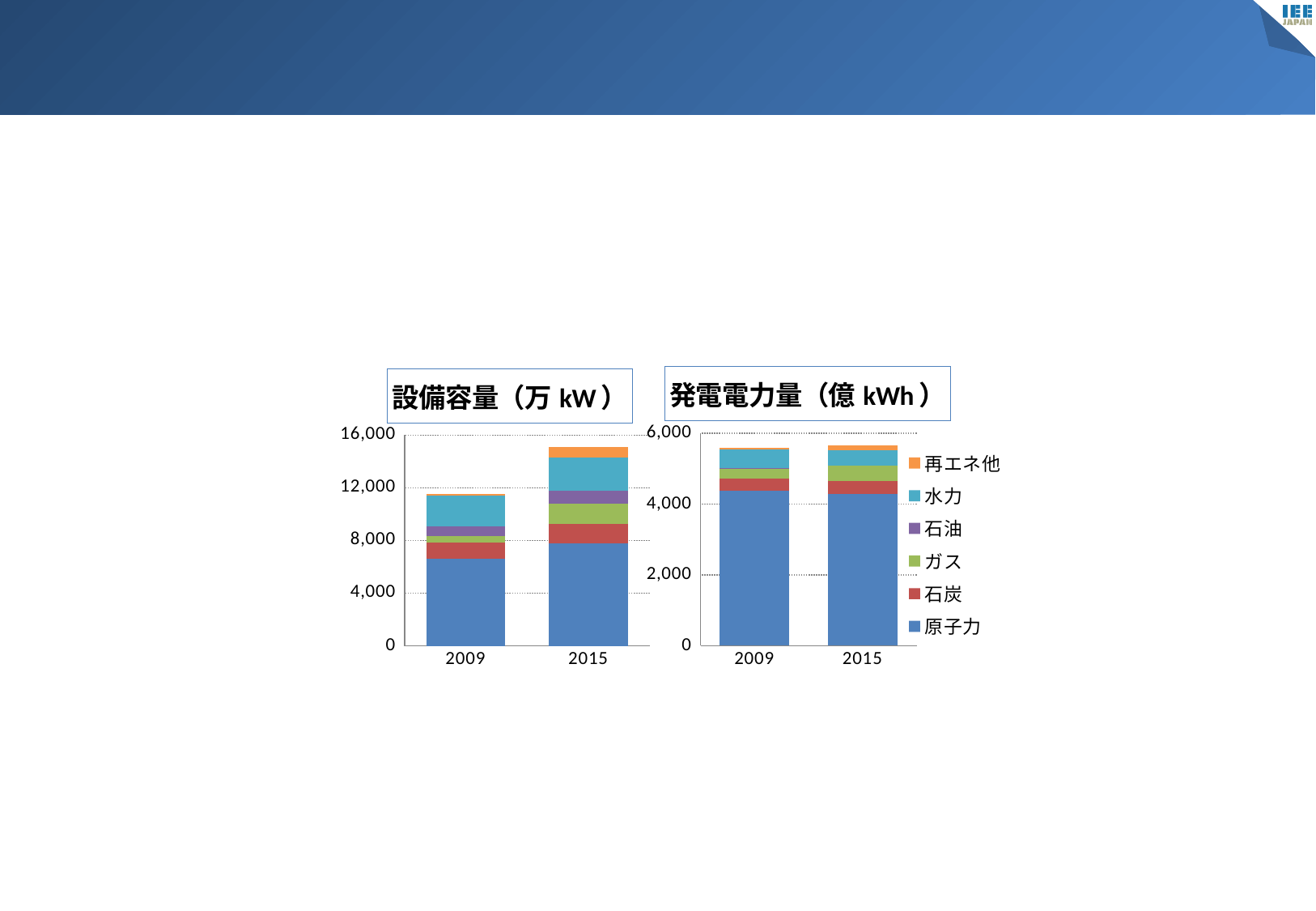
In the 設備容量（万 kW） chart, is the total stacked value for 2009 greater or less than 12,000? less How many series does the legend list for the charts? 6 In the 設備容量（万 kW） chart, does the total stacked value rise or fall from 2009 to 2015? rise Which legend entry is shown in orange? 再エネ他 In the 設備容量（万 kW） chart, how many years are shown on the x axis? 2 In the 発電電力量（億 kWh） chart, is the total stacked value for 2009 greater or less than 4,000? greater What kind of chart is the 設備容量（万 kW） chart on the left? stacked bar chart In the 設備容量（万 kW） chart, is the 原子力 segment for 2009 greater or less than 8,000? less What kind of chart is the 発電電力量（億 kWh） chart on the right? stacked bar chart In the 設備容量（万 kW） chart, which year has the larger total stacked bar, 2009 or 2015? 2015